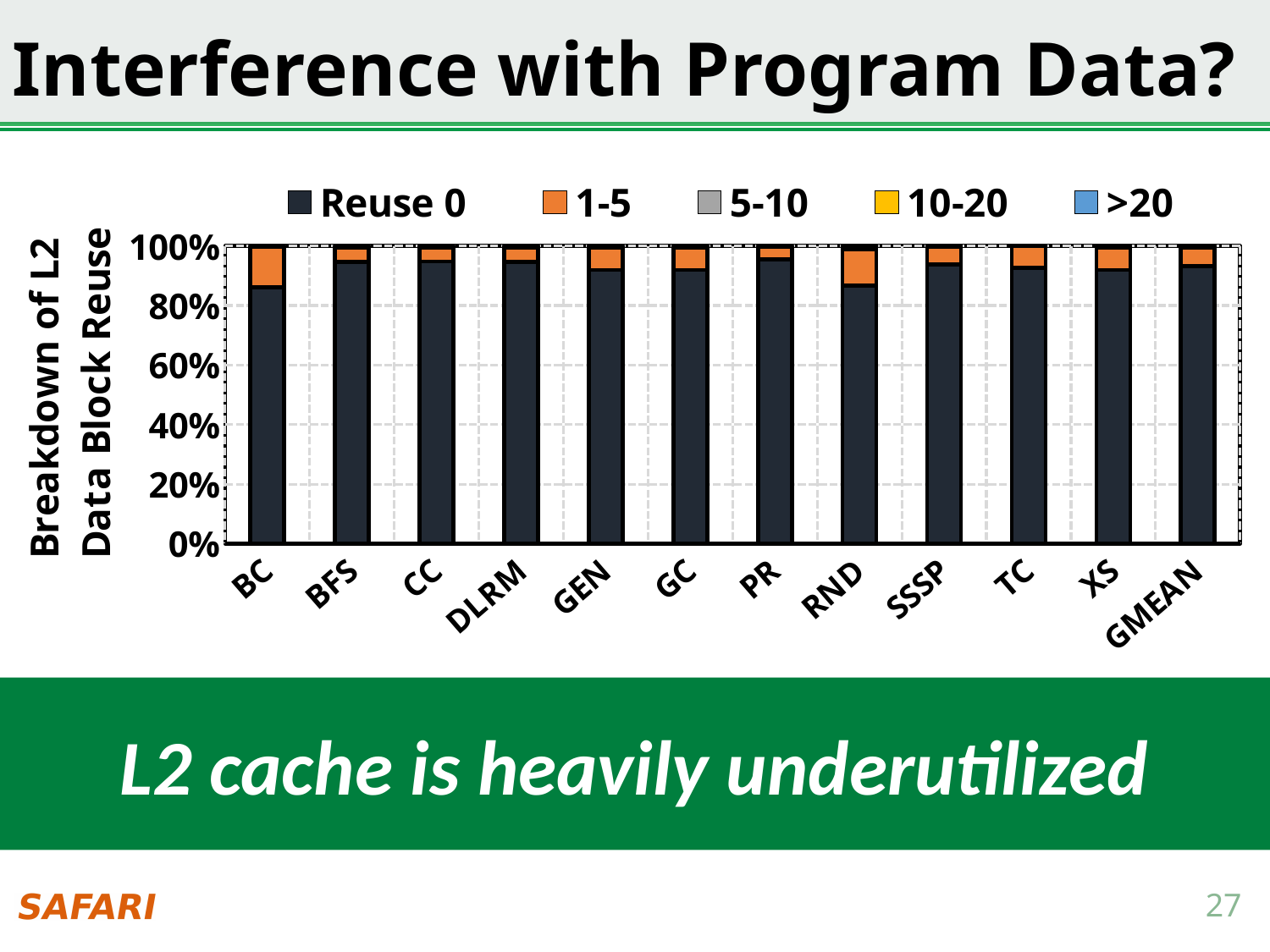
What kind of chart is shown on the slide? stacked bar chart Is the 1-5 value for BC greater or less than 20%? less Is the Reuse 0 value for BFS greater or less than 90%? greater Which has the larger 1-5 value, BC or PR? BC What is the label of the y axis of the chart? Breakdown of L2 Data Block Reuse Which legend entry is shown in orange? 1-5 What is the total height of the stacked bar for GMEAN? 100% Is the Reuse 0 value for RND greater or less than 80%? greater How many series does the chart's legend list? 5 How many categories are shown along the x axis of the chart? 12 Which has the larger Reuse 0 value, BC or BFS? BFS